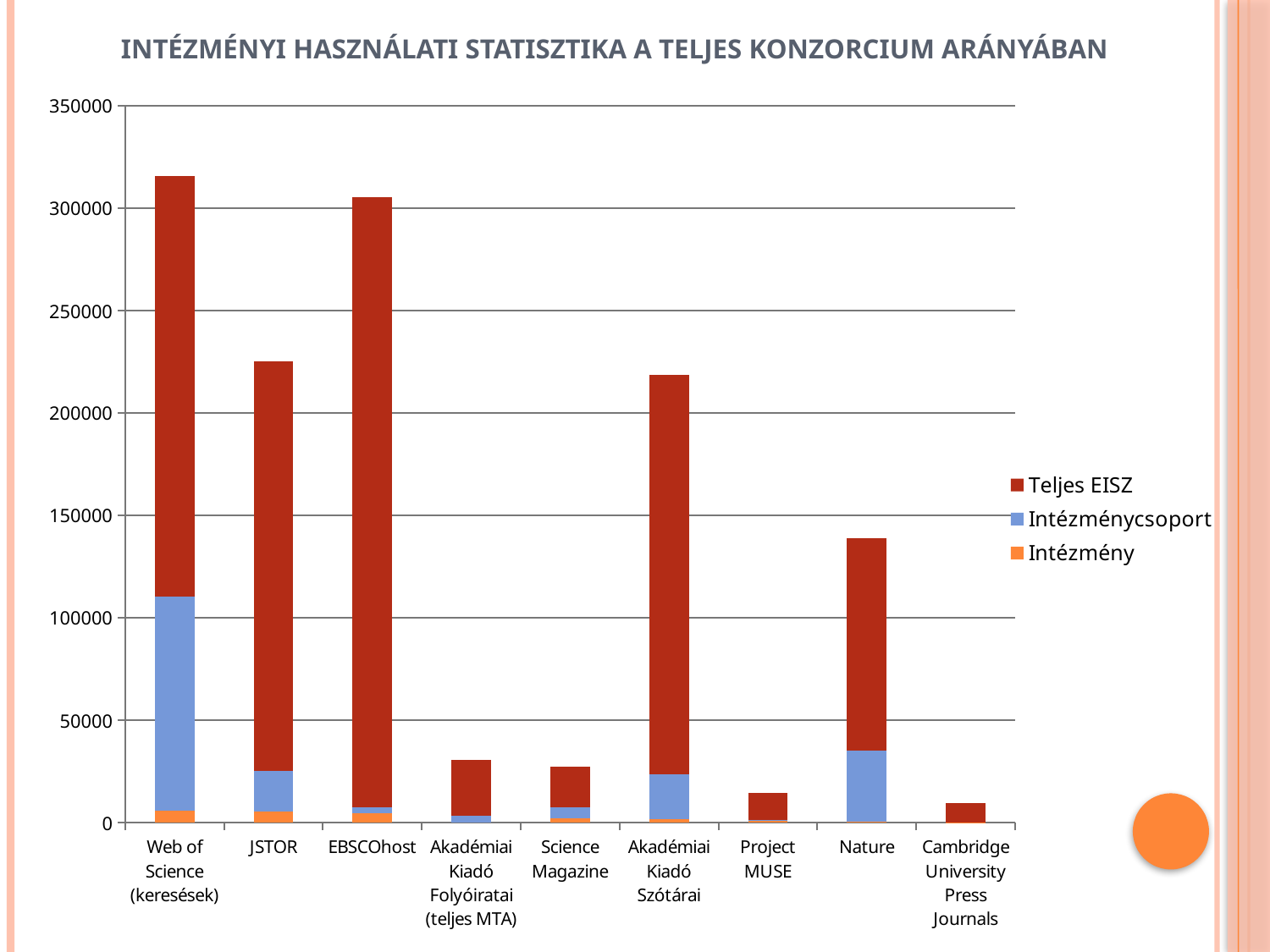
Is the total bar for JSTOR greater or less than 200000? greater Which has the taller total bar, JSTOR or Nature? JSTOR Which category has the tallest total bar? Web of Science (keresések) What is the title of the chart? INTÉZMÉNYI HASZNÁLATI STATISZTIKA A TELJES KONZORCIUM ARÁNYÁBAN Is the total bar for Web of Science (keresések) greater or less than 300000? greater Which has the taller total bar, Science Magazine or Project MUSE? Science Magazine How many categories are shown on the x axis of the chart? 9 How many series does the legend list? 3 Is the total bar for Nature greater or less than 150000? less Which category has the shortest total bar? Cambridge University Press Journals What kind of chart is shown on the slide? Stacked bar chart